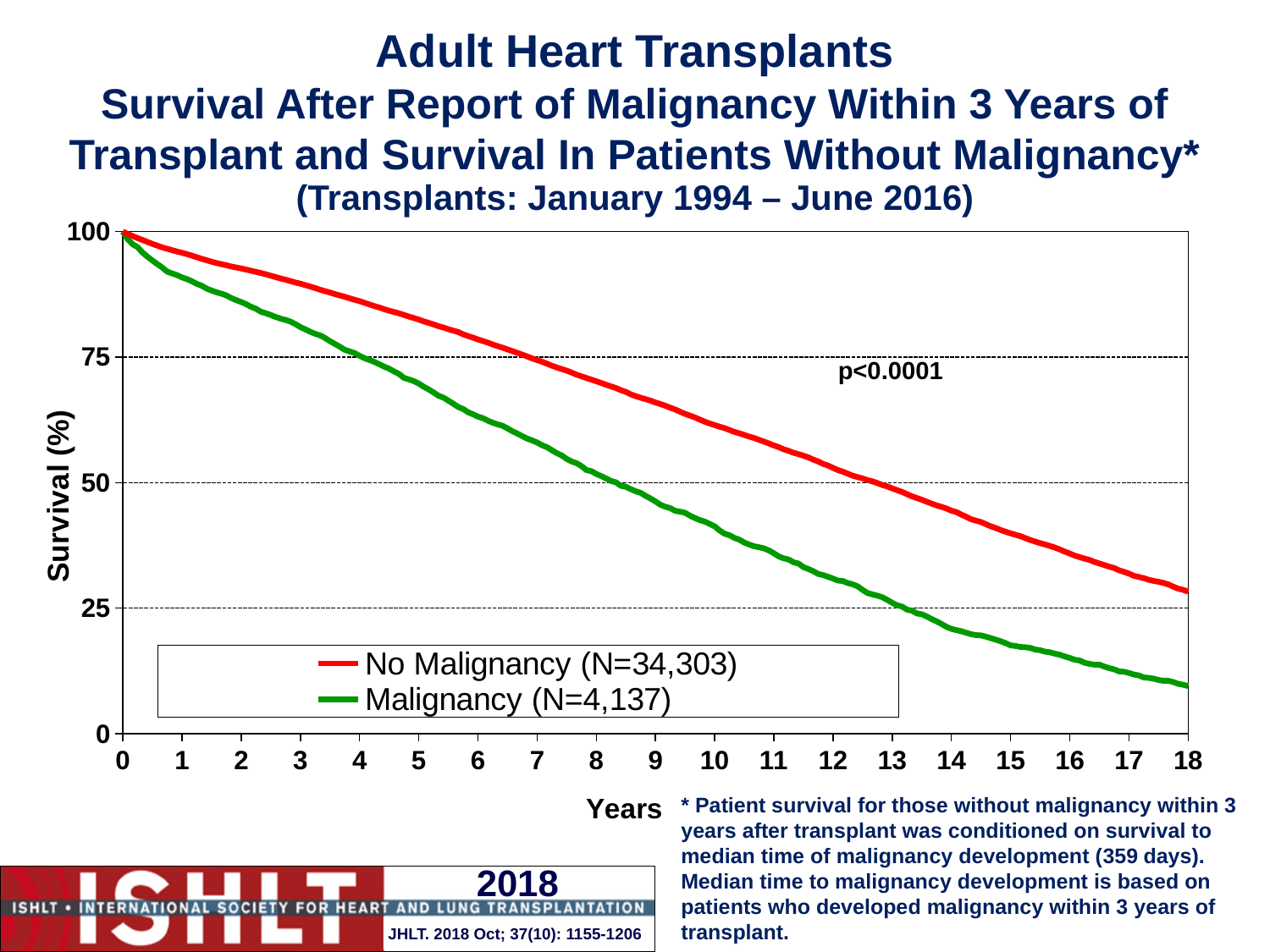
Is the survival value for the Malignancy group at 5 years greater or less than 75? less Is the survival value for the No Malignancy group at 5 years greater or less than 75? greater Is the survival value for the No Malignancy group at 10 years greater or less than 50? greater What p-value is printed on the chart? p<0.0001 What kind of chart is shown on the slide? line chart What is the number of patients (N) in the Malignancy group according to the legend? 4,137 How many series does the legend list? 2 At 10 years, which group has higher survival: No Malignancy or Malignancy? No Malignancy Do the survival curves rise or fall as years since transplant increase? fall